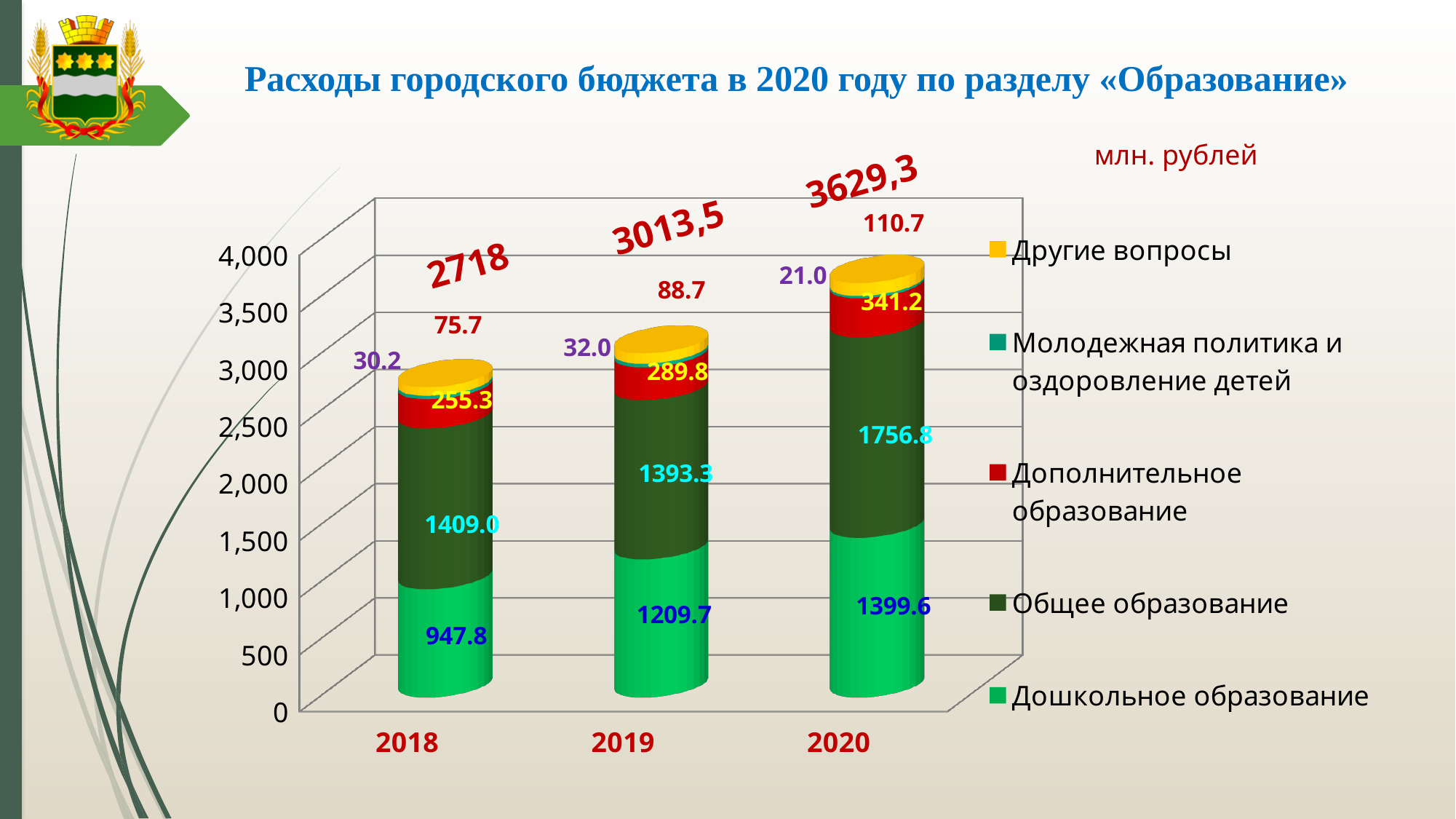
What is the difference between Дошкольное образование in 2020 and in 2019? 189.9 How many series does the legend list? 5 Which is larger: Другие вопросы in 2018 or in 2019? 2019 What is the value for Общее образование in 2020? 1756.8 What is the value for Молодежная политика и оздоровление детей in 2020? 21.0 Do the total expenditures rise or fall from 2018 to 2020? rise What is the value for Дошкольное образование in 2018? 947.8 What type of chart is shown on the slide? stacked bar chart How many years are shown on the x axis? 3 What is the value for Дополнительное образование in 2019? 289.8 What is the total of the stacked bar for 2019? 3013,5 Which year has the highest total expenditure? 2020